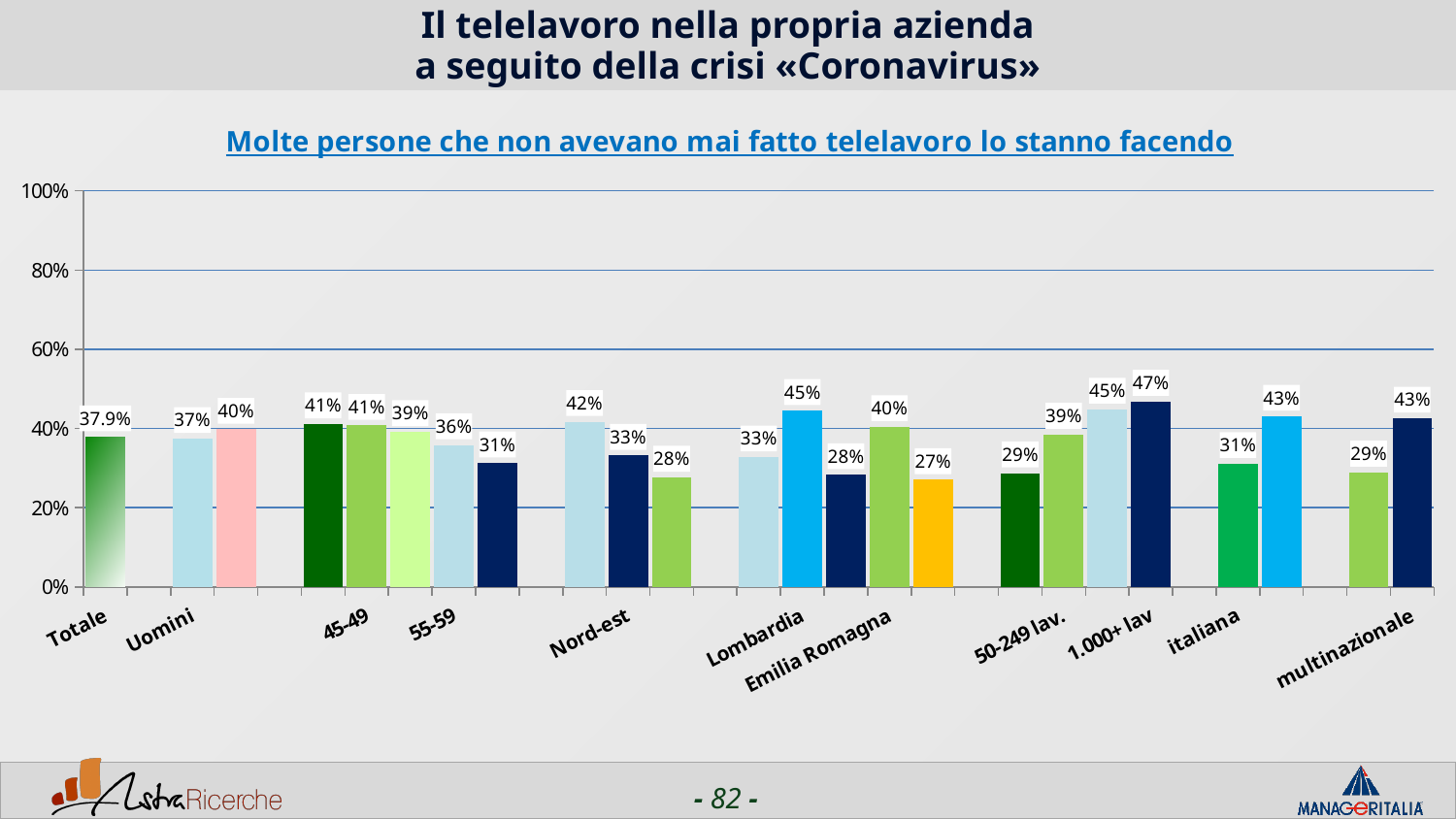
What is the value for Uomini? 37% Which labelled category has the highest value? 1.000+ lav What is the value for Totale? 37.9% What is the difference between the values for 1.000+ lav and 50-249 lav.? 8 percentage points Which is larger, the value for italiana or for multinazionale? multinazionale Which is larger, the value for Lombardia or for Emilia Romagna? Lombardia What is the value for italiana? 31% What kind of chart is shown on the slide? Bar chart What is the highest value shown on the vertical axis? 100% Is the value for Totale greater or less than 40%? less What is the value for multinazionale? 43% What is the value for 1.000+ lav? 47%